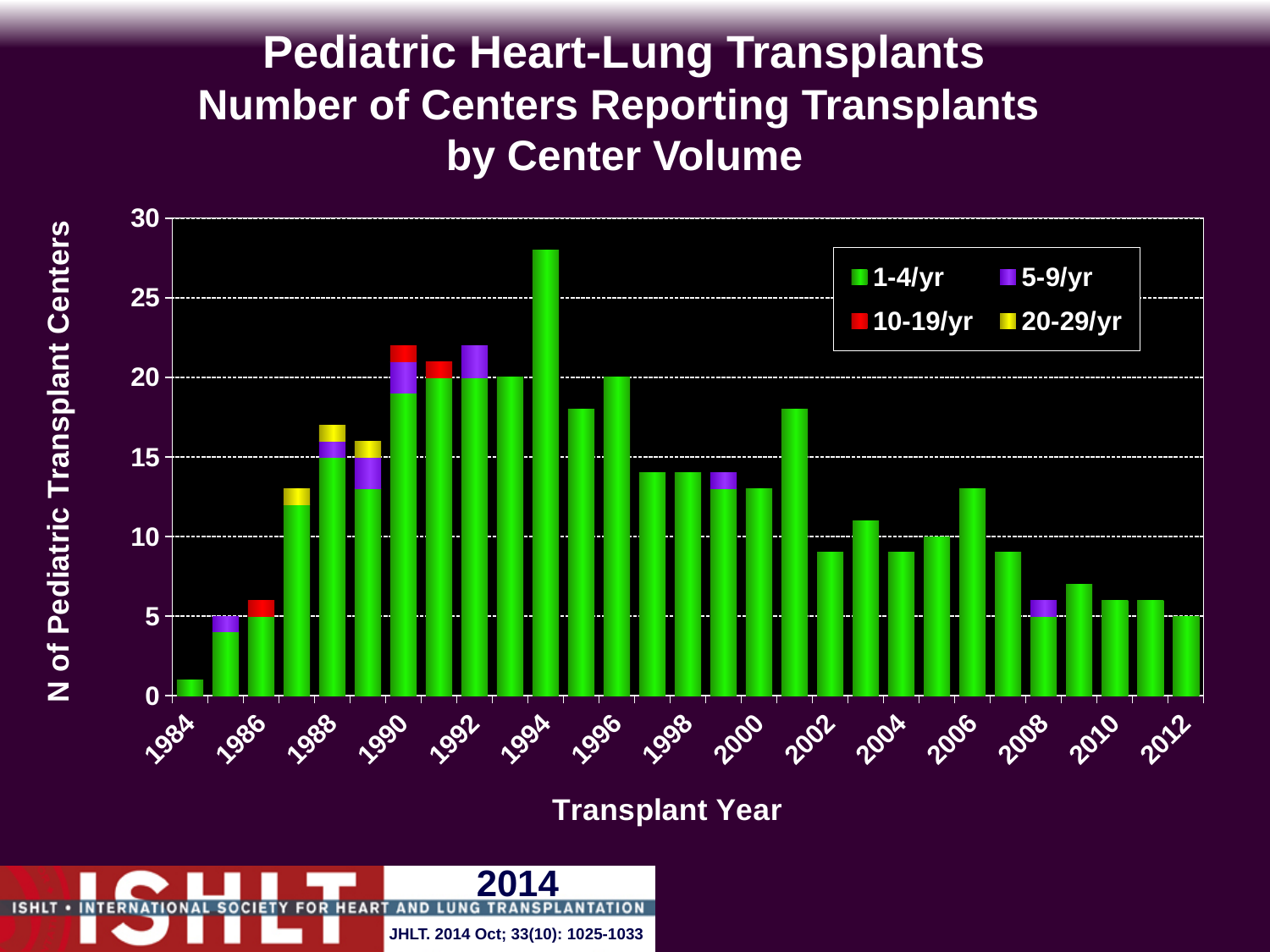
What is the total number of pediatric transplant centers reported for 1996? 20 Which colour represents the 1-4/yr center volume category in the legend? Green How many series does the legend list? 4 Which transplant year has the lowest total number of pediatric transplant centers? 1984 Is the total number of centers for 1994 greater or less than 25? greater Which year has more reporting centers in total, 2001 or 2002? 2001 What kind of chart is shown on the slide? Stacked bar chart Which transplant year has the highest total number of pediatric transplant centers? 1994 From 2001 to 2012, do the total numbers of reporting centers generally rise or fall? Fall What is the total number of pediatric transplant centers reported for 2012? 5 Is the total number of centers for 2002 greater or less than 10? less What is the total number of pediatric transplant centers reported for 2005? 10